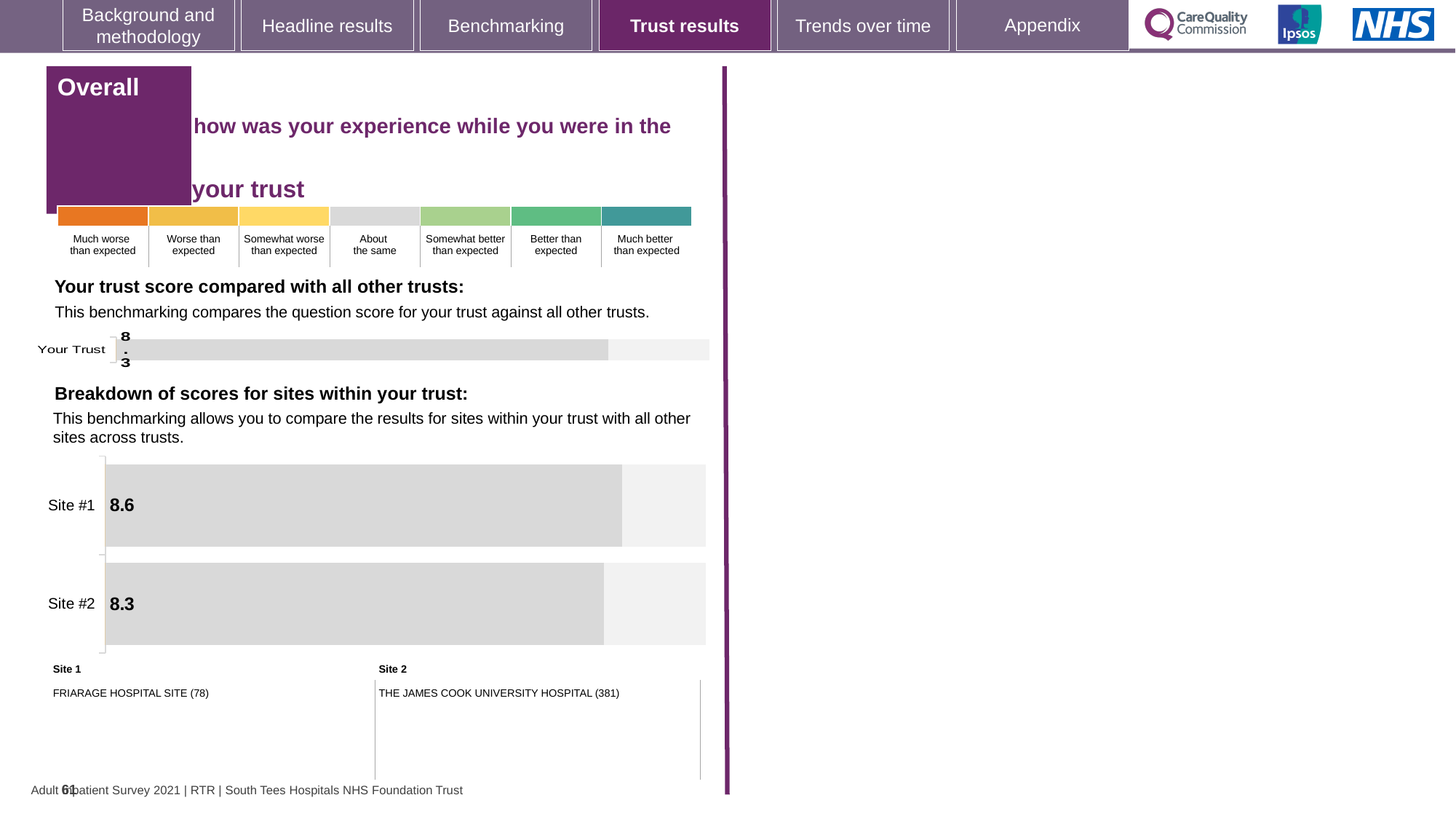
In the 'Your trust score compared with all other trusts' chart, what is the score shown for Your Trust? 8.3 In the 'Breakdown of scores for sites within your trust' chart, is the score for Site #1 larger or smaller than the score for Site #2? larger In the 'Breakdown of scores for sites within your trust' chart, what is the difference between the scores for Site #1 and Site #2? 0.3 In the 'Breakdown of scores for sites within your trust' chart, what is the score for Site #1? 8.6 According to the key below the site chart, which hospital is Site 2? THE JAMES COOK UNIVERSITY HOSPITAL (381) In the 'Breakdown of scores for sites within your trust' chart, what is the score for Site #2? 8.3 How many bars are shown in the 'Your trust score compared with all other trusts' chart? 1 According to the key below the site chart, which hospital is Site 1? FRIARAGE HOSPITAL SITE (78) In the 'Breakdown of scores for sites within your trust' chart, which site has the lower score? Site #2 In the 'Breakdown of scores for sites within your trust' chart, which site has the higher score? Site #1 How many sites are plotted in the 'Breakdown of scores for sites within your trust' chart? 2 What kind of chart is the 'Breakdown of scores for sites within your trust' chart? bar chart